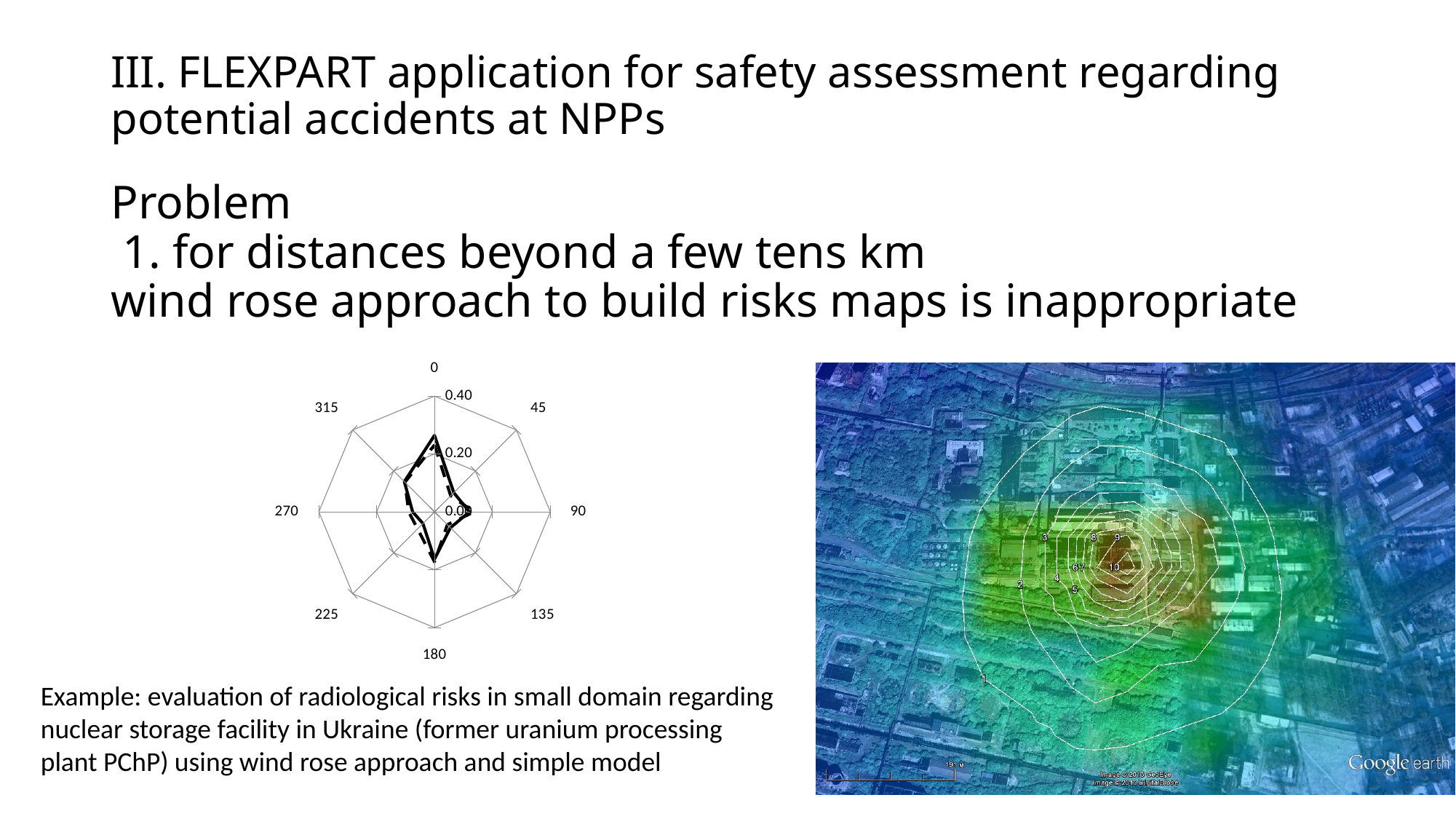
Is the solid-line value in the 90 direction greater or less than 0.20? less In which direction does the solid line of the radar chart reach its highest value? 0 Is the solid-line value in the 0 direction greater or less than 0.20? greater Which direction has the larger solid-line value on the radar chart, 0 or 90? 0 Which direction has the larger solid-line value on the radar chart, 0 or 270? 0 What kind of chart is shown on the left of the slide? radar chart What is the largest value labelled on the radial axis of the radar chart? 0.40 How many direction categories are labelled around the radar chart? 8 Is the solid-line value in the 135 direction greater or less than 0.20? less Which direction label appears at the top of the radar chart? 0 How many lines (series) are plotted on the radar chart? 2